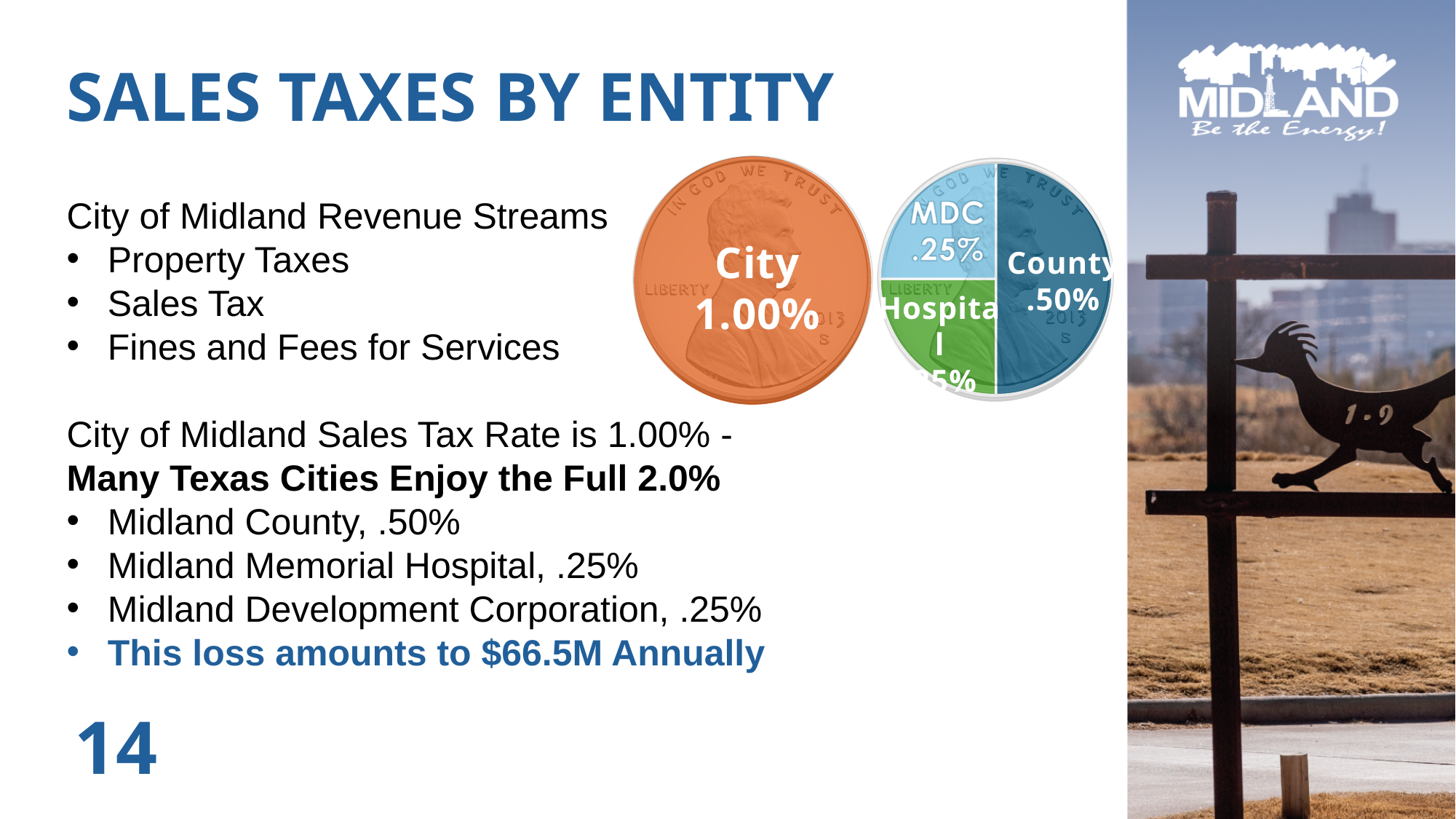
What is the total of all slices in the pie chart on the penny? 1.00% What colour is the Hospital slice in the pie chart on the penny? Green What colour is the County slice in the pie chart on the penny? Dark blue In the pie chart on the penny, what is the difference between the County value and the MDC value? .25% In the pie chart on the penny, which slice has the largest value? County What share of the pie chart on the penny does the County slice take up? Half (50%) In the pie chart on the penny, what is the value shown for Hospital? .25% In the pie chart on the penny, what is the value shown for MDC? .25% In the pie chart on the penny, what is the value shown for County? .50% In the pie chart on the penny, which is larger, County or MDC? County How many slices does the pie chart on the penny have? 3 What kind of chart is drawn over the second penny? Pie chart